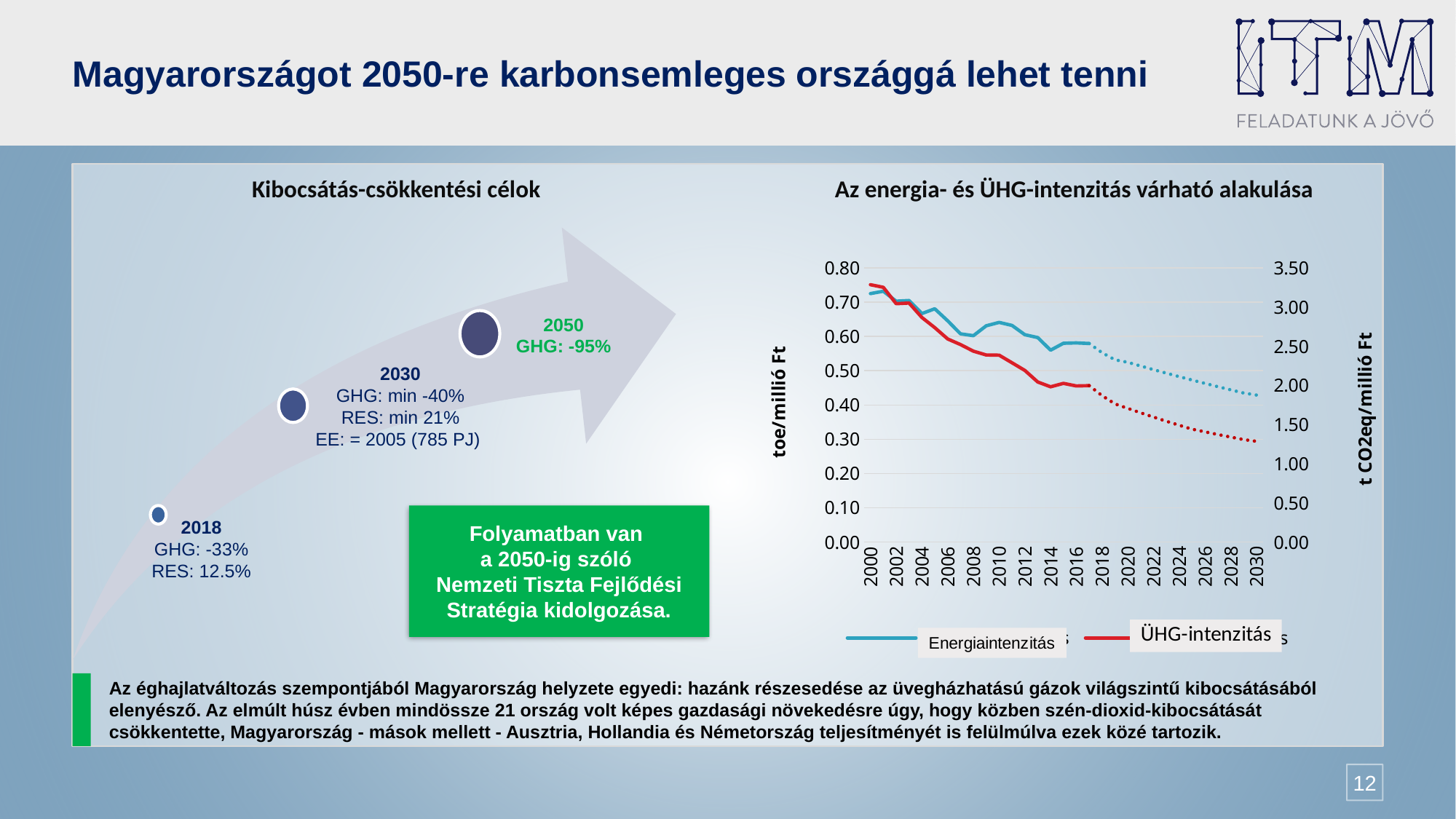
In the chart "Az energia- és ÜHG-intenzitás várható alakulása", is the Energiaintenzitás value for 2030 greater or less than 0.50 on the left axis? less How many series does the legend of the chart "Az energia- és ÜHG-intenzitás várható alakulása" list? 2 In the chart "Az energia- és ÜHG-intenzitás várható alakulása", what is the unit label on the left vertical axis? toe/millió Ft In the chart "Az energia- és ÜHG-intenzitás várható alakulása", what is the last year shown on the x axis? 2030 In the chart "Az energia- és ÜHG-intenzitás várható alakulása", is the ÜHG-intenzitás value for 2000 greater or less than 3.00 on the right axis? greater In the chart "Az energia- és ÜHG-intenzitás várható alakulása", what is the first year shown on the x axis? 2000 In the chart "Az energia- és ÜHG-intenzitás várható alakulása", does the ÜHG-intenzitás series rise or fall from 2000 to 2030? fall In the chart "Az energia- és ÜHG-intenzitás várható alakulása", is the ÜHG-intenzitás value for 2030 greater or less than 1.50 on the right axis? less In the chart "Az energia- és ÜHG-intenzitás várható alakulása", does the Energiaintenzitás series rise or fall from 2000 to 2030? fall In the chart "Az energia- és ÜHG-intenzitás várható alakulása", which series is drawn in red? ÜHG-intenzitás What kind of chart is shown under the title "Az energia- és ÜHG-intenzitás várható alakulása"? line chart